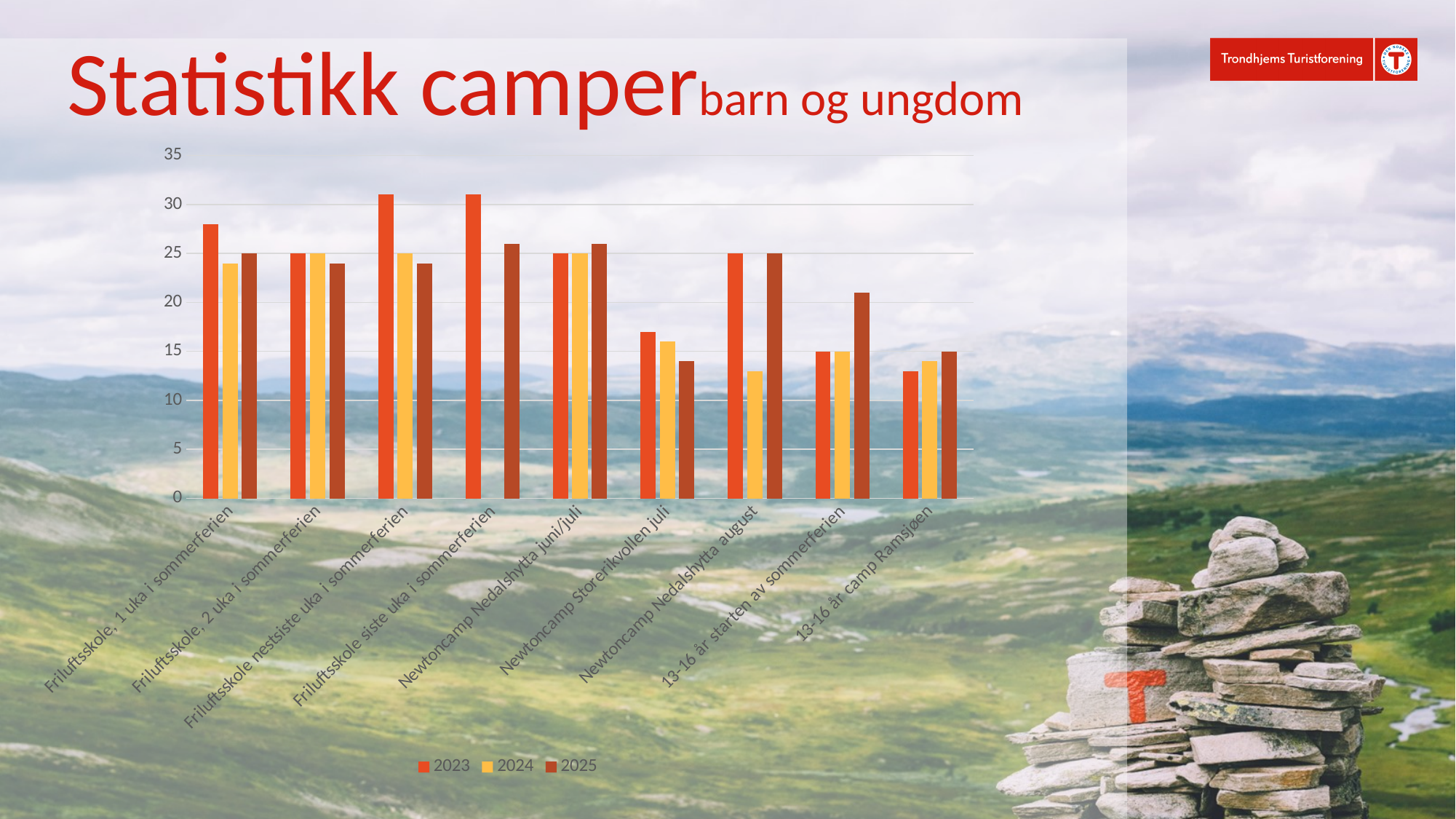
Is the 2023 value for "Friluftsskole, 1 uka i sommerferien" greater or less than 25? greater What kind of chart is shown on the slide? bar chart For "Friluftsskole, 1 uka i sommerferien", which year has the larger value, 2023 or 2024? 2023 For "Newtoncamp Nedalshytta august", which year has the larger value, 2024 or 2025? 2025 How many categories are shown along the x axis? 9 Is the 2025 value for "Newtoncamp Storerikvollen juli" greater or less than 15? less Which category has the lowest 2023 value? 13-16 år camp Ramsjøen Is the 2024 value for "Newtoncamp Nedalshytta august" greater or less than 15? less Which years are listed in the legend? 2023, 2024, 2025 How many series does the legend list? 3